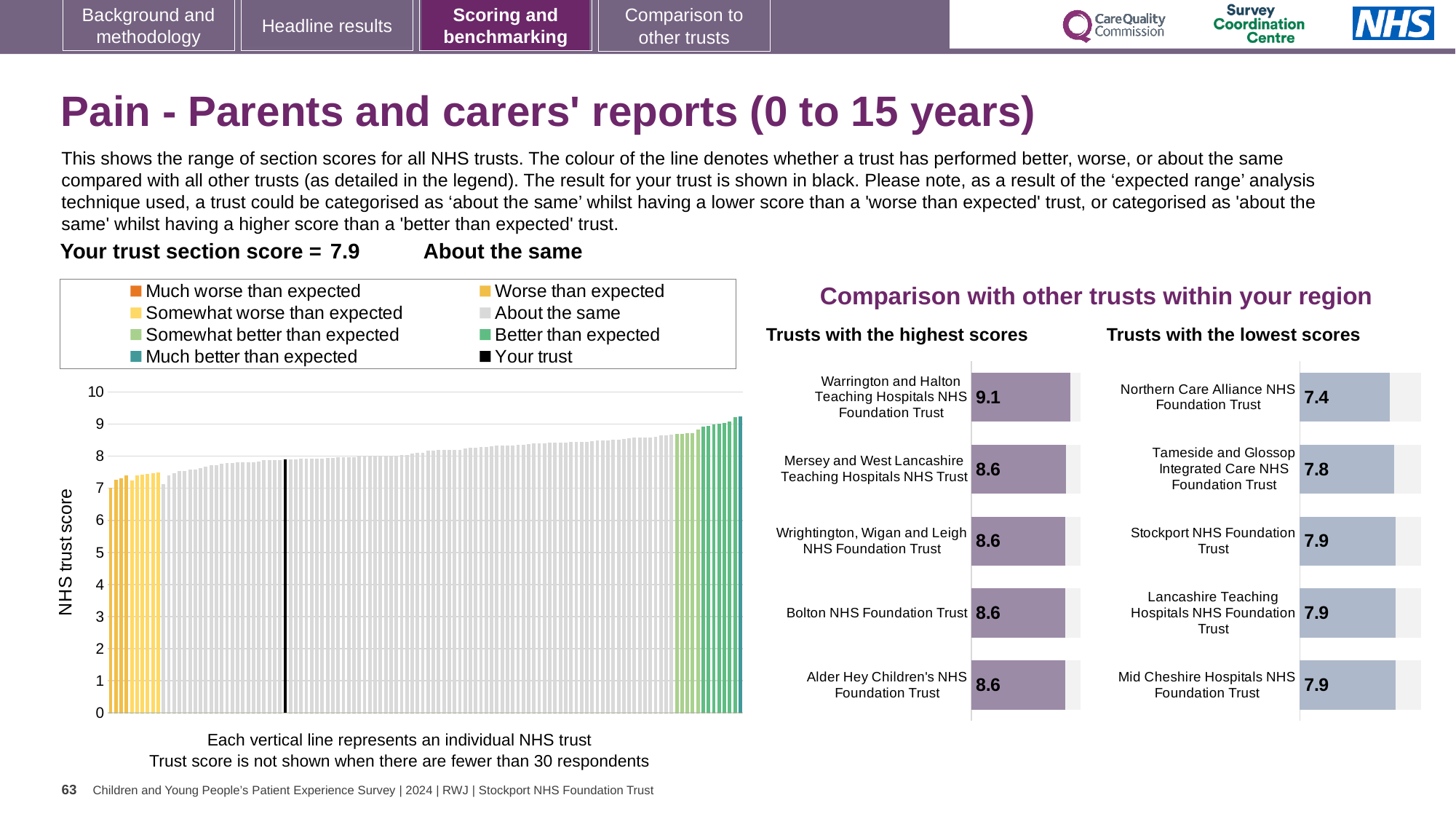
In the 'Trusts with the lowest scores' chart, which has the higher score: Tameside and Glossop Integrated Care NHS Foundation Trust or Stockport NHS Foundation Trust? Stockport NHS Foundation Trust In the 'Trusts with the highest scores' chart, what is the difference between the scores of Warrington and Halton Teaching Hospitals NHS Foundation Trust and Bolton NHS Foundation Trust? 0.5 In the 'Trusts with the lowest scores' chart, what is the difference between the scores of Stockport NHS Foundation Trust and Northern Care Alliance NHS Foundation Trust? 0.5 In the 'Trusts with the lowest scores' chart, what is the score for Northern Care Alliance NHS Foundation Trust? 7.4 In the large chart on the left, do the trust scores rise or fall from left to right? Rise In the 'Trusts with the lowest scores' chart, which trust has the lowest score? Northern Care Alliance NHS Foundation Trust What kind of chart is the large chart on the left showing all NHS trusts? Bar chart What is the y-axis label of the large chart on the left? NHS trust score In the 'Trusts with the highest scores' chart, which trust has the highest score? Warrington and Halton Teaching Hospitals NHS Foundation Trust According to the slide, what is your trust's section score for Pain - Parents and carers' reports? 7.9 In the 'Trusts with the highest scores' chart, what is the score for Warrington and Halton Teaching Hospitals NHS Foundation Trust? 9.1 How many trusts are shown in the 'Trusts with the highest scores' chart? 5